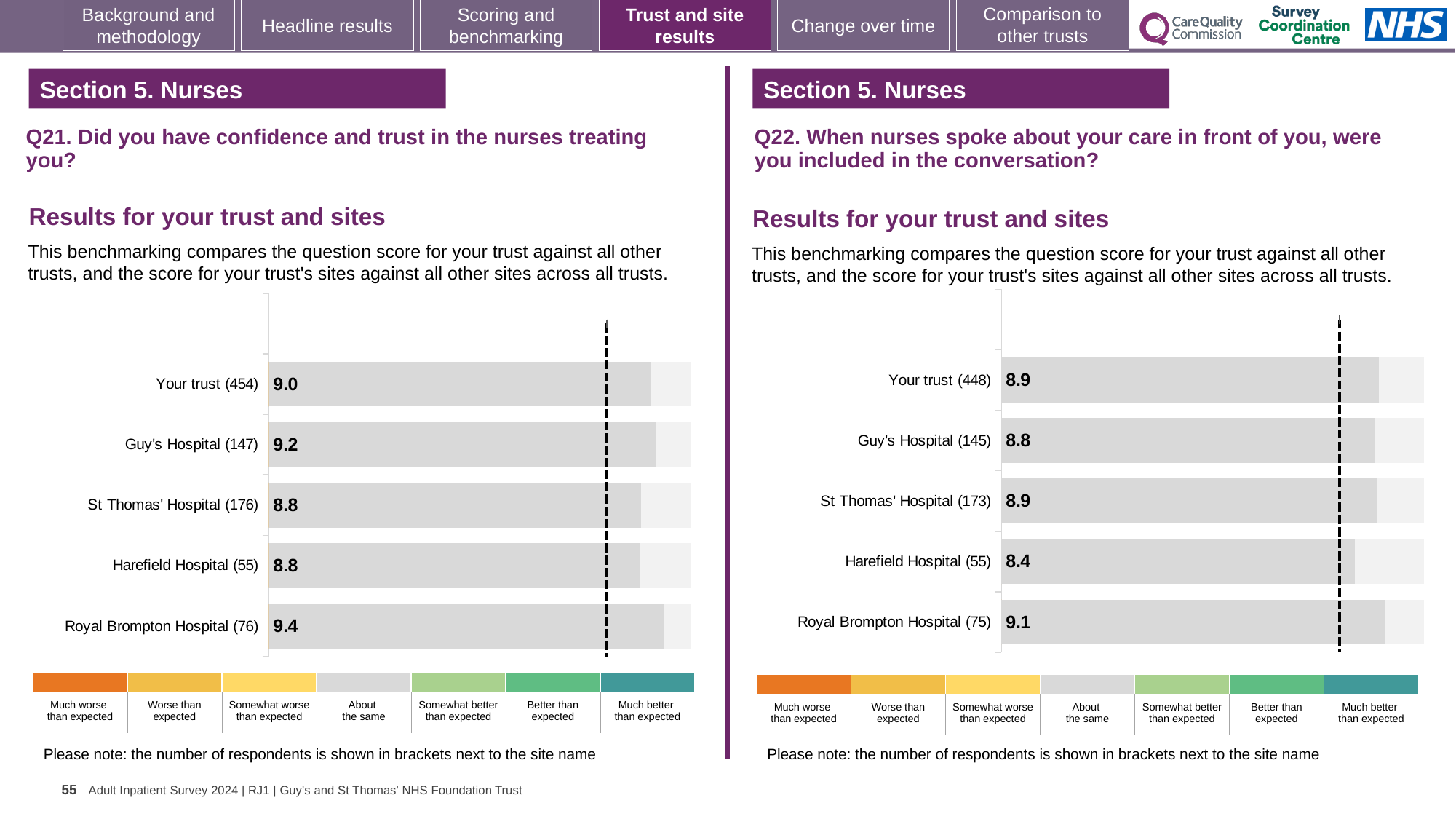
In the Q22 chart on the right, how many respondents are shown in brackets for St Thomas' Hospital? 173 What type of chart is used on the left for Q21? Bar chart In the Q22 chart on the right, which site has the highest score? Royal Brompton Hospital In the Q22 chart on the right, which is larger: the score for Your trust or the score for Guy's Hospital? Your trust In the Q21 chart on the left, how many bars are plotted? 5 In the Q21 chart on the left, what is the difference between the scores for Guy's Hospital and St Thomas' Hospital? 0.4 In the Q22 chart on the right, what is the score for Harefield Hospital? 8.4 In the Q21 chart on the left, what is the score for Royal Brompton Hospital? 9.4 In the Q21 chart on the left, what is the score for Your trust? 9.0 In the Q21 chart on the left, which site has the highest score? Royal Brompton Hospital In the Q22 chart on the right, which site has the lowest score? Harefield Hospital In the Q22 chart on the right, what is the difference between the scores for Royal Brompton Hospital and Harefield Hospital? 0.7